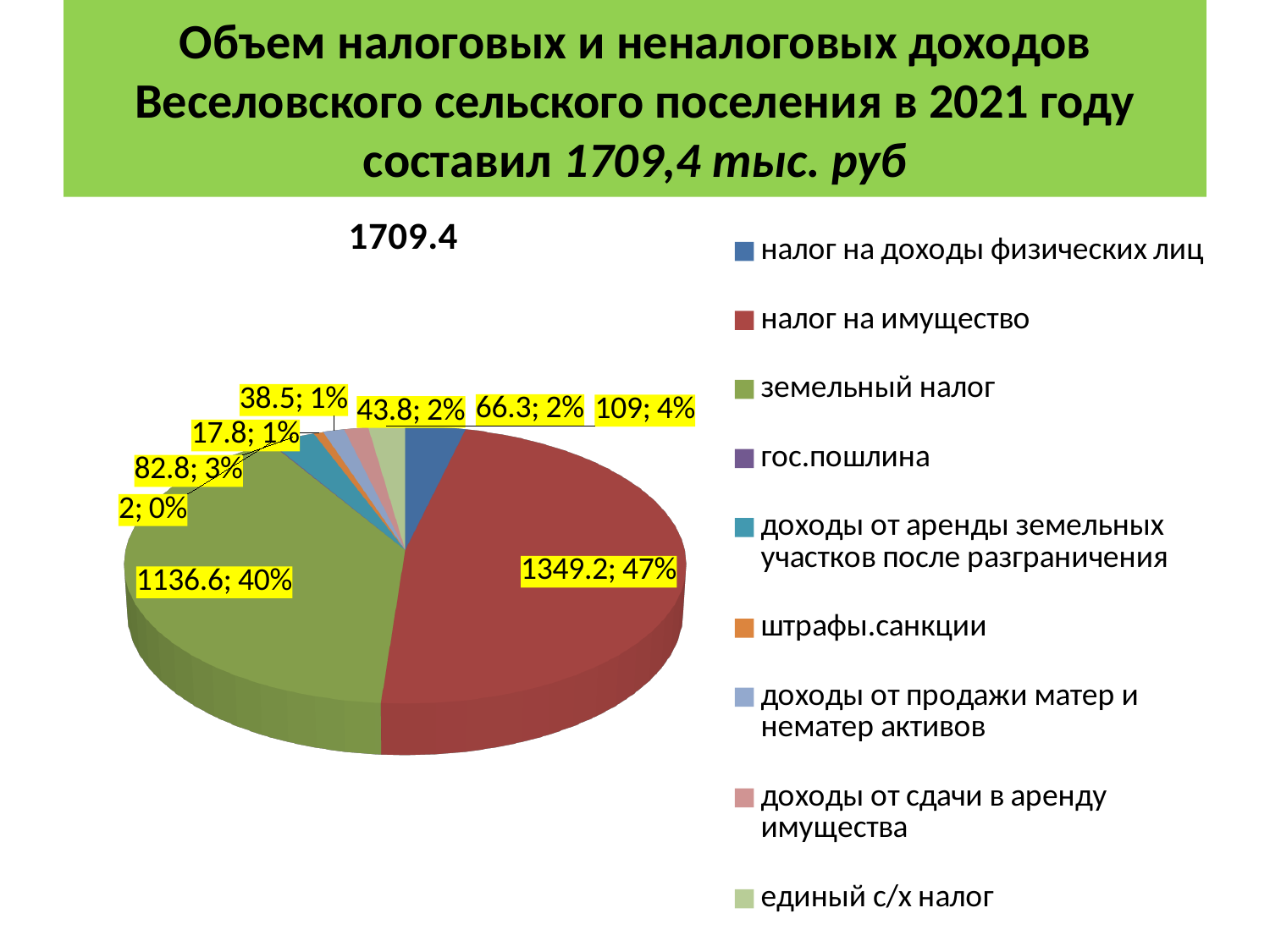
What is the difference between the values for налог на имущество and земельный налог? 212.6 What is the value shown for налог на доходы физических лиц? 109 How many entries does the legend list? 9 What kind of chart is shown on the slide? pie chart Which is larger, the value for доходы от аренды земельных участков после разграничения or the value for штрафы.санкции? доходы от аренды земельных участков после разграничения What share of the pie does налог на имущество represent? 47% Which category has the largest slice of the pie? налог на имущество What is the value shown for земельный налог? 1136.6 Which category has the smallest slice of the pie? гос.пошлина What share of the pie does земельный налог represent? 40% What is the value shown for налог на имущество? 1349.2 What is the value shown for единый с/х налог? 66.3